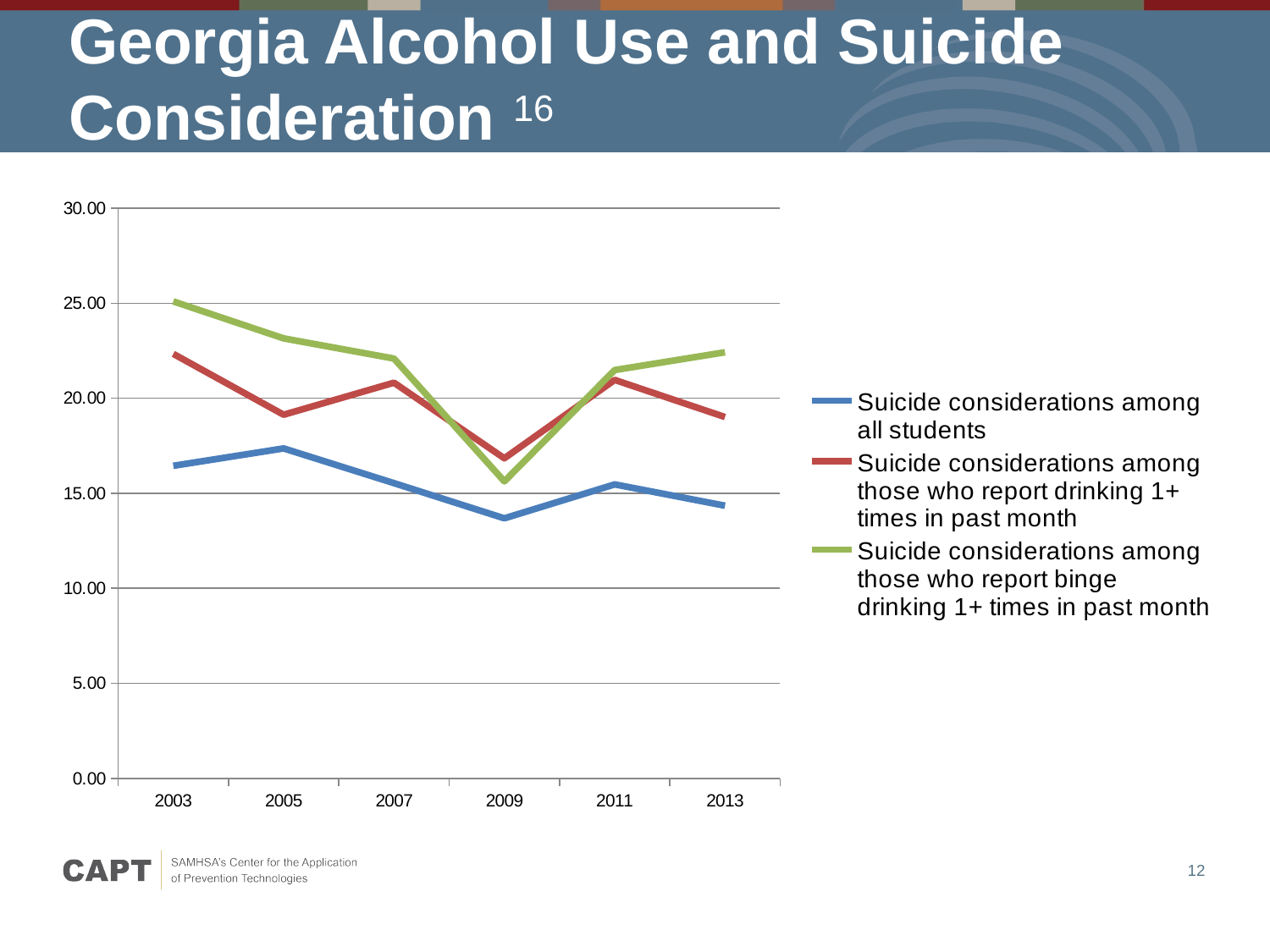
What colour is the line for suicide considerations among all students? blue In 2003, which is larger: suicide considerations among all students or suicide considerations among those who report binge drinking 1+ times in past month? Suicide considerations among those who report binge drinking 1+ times in past month Is the value for suicide considerations among all students in 2005 greater or less than 15.00? greater In which year is the value for suicide considerations among all students lowest? 2009 Is the value for suicide considerations among those who report drinking 1+ times in past month in 2009 greater or less than 20.00? less Does the value for suicide considerations among those who report binge drinking 1+ times in past month rise or fall from 2003 to 2009? fall How many series does the legend list? 3 How many years are plotted along the x axis? 6 Is the value for suicide considerations among all students in 2009 greater or less than 15.00? less In which year is the value for suicide considerations among those who report binge drinking 1+ times in past month highest? 2003 What kind of chart is shown on the slide? line chart